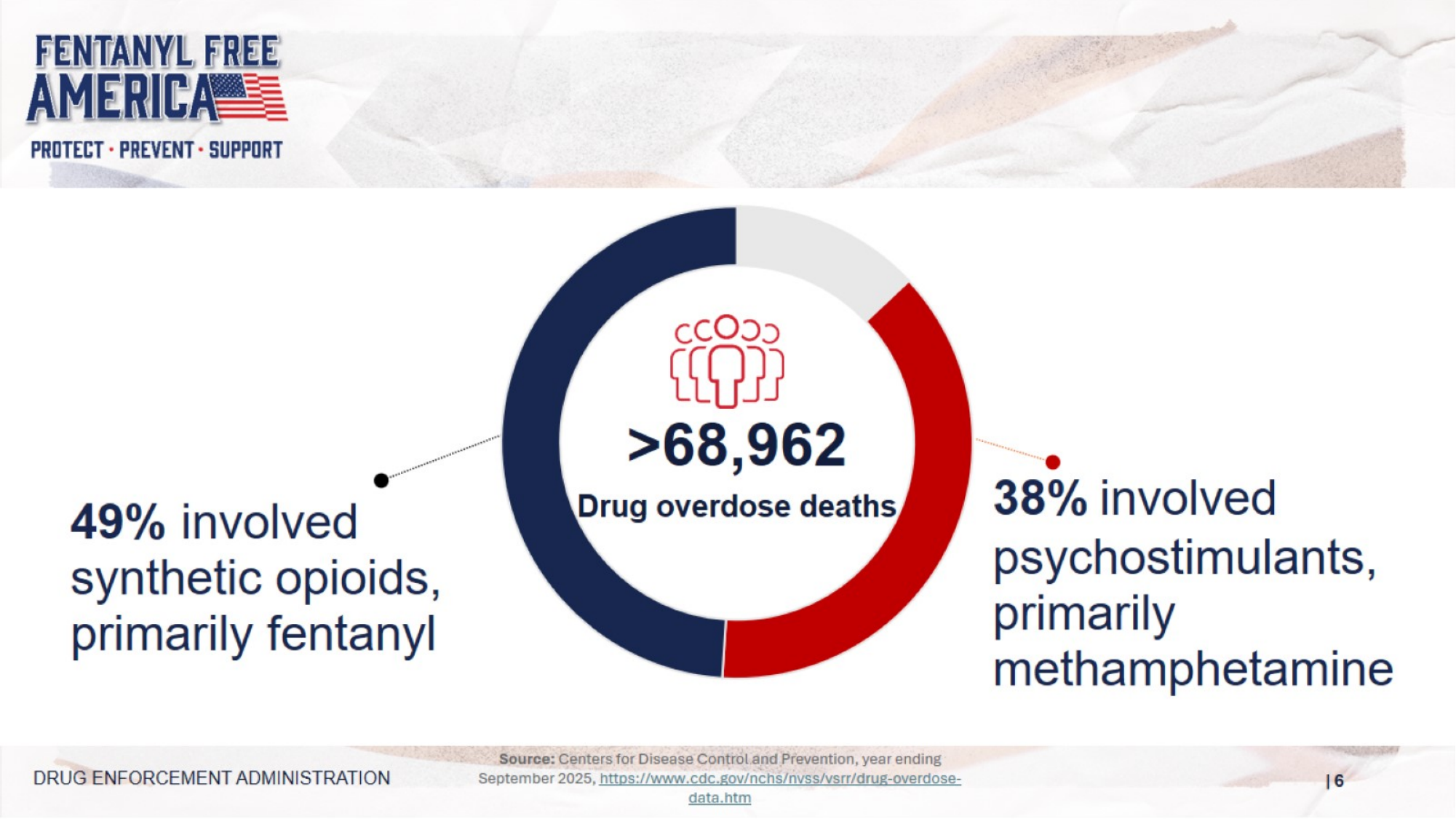
What colour is the segment representing psychostimulants? Red What kind of chart is shown on the slide? Donut (pie) chart Is the share involving psychostimulants greater or less than 50%? less By how many percentage points does the synthetic opioids share exceed the psychostimulants share? 11 percentage points Which labelled category accounts for the largest share of the chart? Synthetic opioids, primarily fentanyl What number of drug overdose deaths is shown in the centre of the chart? >68,962 What percentage of drug overdose deaths involved psychostimulants, primarily methamphetamine? 38% How many segments does the donut chart have? 3 Which labelled category accounts for the smaller share of the chart? Psychostimulants, primarily methamphetamine Which is larger: the share involving synthetic opioids or the share involving psychostimulants? Synthetic opioids What colour is the segment representing synthetic opioids? Navy blue What percentage of drug overdose deaths involved synthetic opioids, primarily fentanyl? 49%